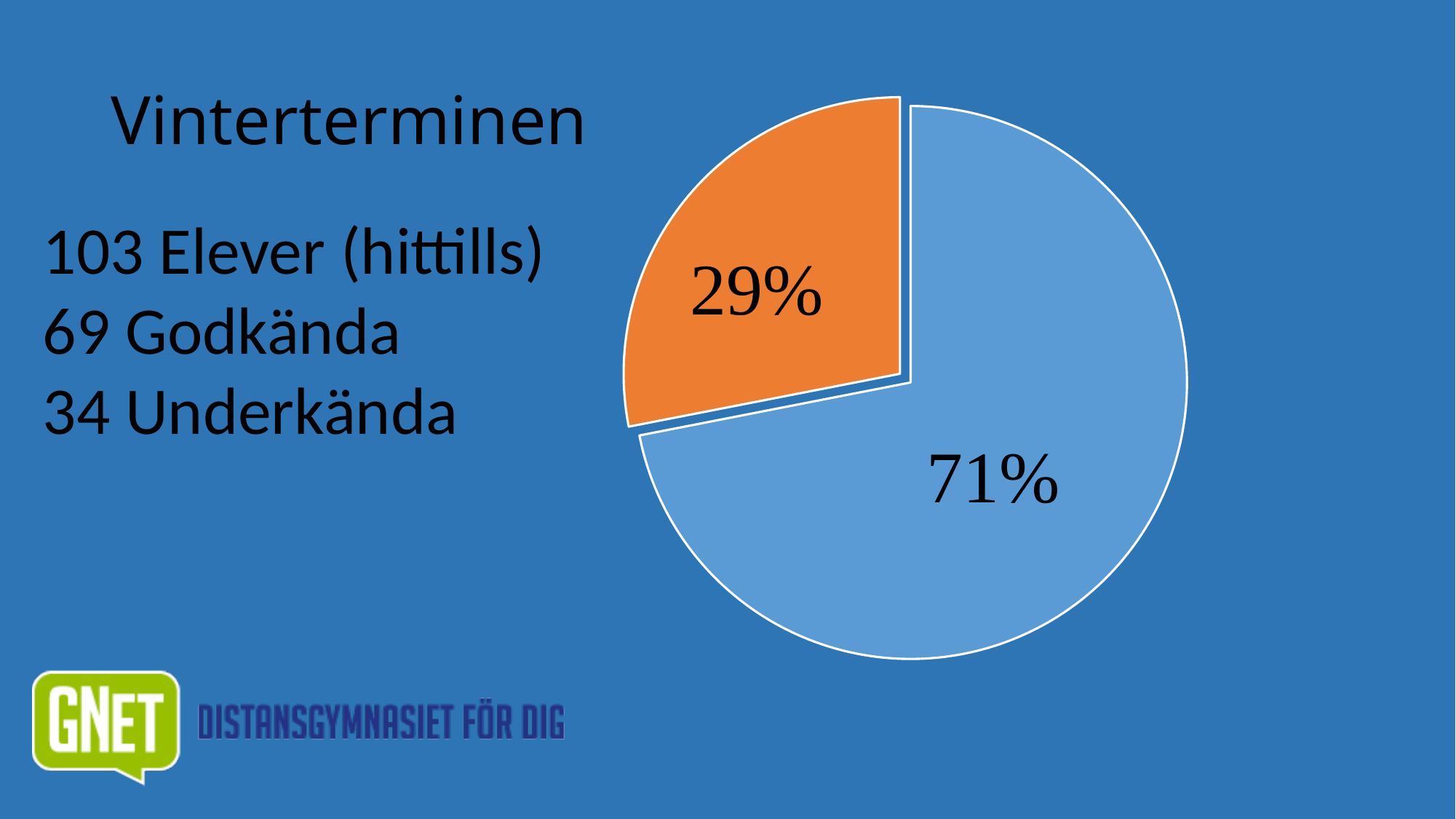
Does the pie chart display a legend? No What is the difference in percentage points between the blue slice and the orange slice? 42 How many slices does the pie chart have? 2 What value is printed on the orange slice of the pie chart? 29% What kind of chart is shown on the slide? pie chart What value is printed on the blue slice of the pie chart? 71% What do the two slice percentages add up to? 100% Which slice is larger, the blue one or the orange one? blue What colour is the largest slice of the pie chart? blue What percentage is shown on the largest slice of the pie chart? 71% Is the blue slice greater or less than 50% of the pie? greater What percentage is shown on the smallest slice of the pie chart? 29%